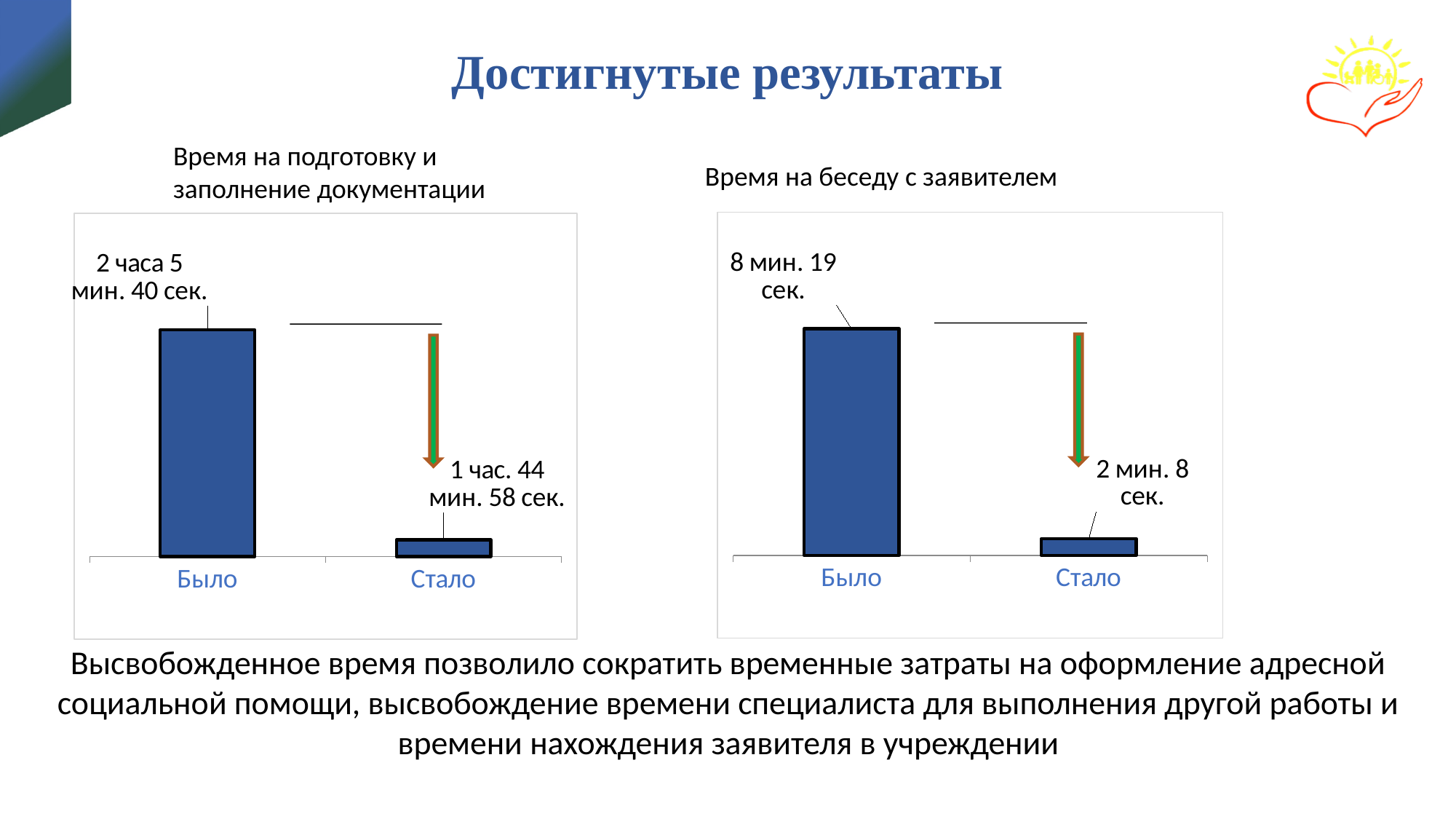
In the right chart (Время на беседу с заявителем), what is the value for Было? 8 мин. 19 сек. In the left chart (Время на подготовку и заполнение документации), what is the value for Было? 2 часа 5 мин. 40 сек. In the left chart (Время на подготовку и заполнение документации), what is the value for Стало? 1 час. 44 мин. 58 сек. In the left chart (Время на подготовку и заполнение документации), by how much does the value for Было exceed the value for Стало? 20 мин. 42 сек. How many categories are shown in the left chart (Время на подготовку и заполнение документации)? 2 In the right chart (Время на беседу с заявителем), which category has the lowest value? Стало In the right chart (Время на беседу с заявителем), do the values rise or fall from Было to Стало? fall In the right chart (Время на беседу с заявителем), what is the value for Стало? 2 мин. 8 сек. In the right chart (Время на беседу с заявителем), what is the difference between Было and Стало? 6 мин. 11 сек. In the right chart (Время на беседу с заявителем), is the value for Было larger or smaller than the value for Стало? larger What type of chart is the right chart (Время на беседу с заявителем)? bar chart In the left chart (Время на подготовку и заполнение документации), which category has the higher value? Было